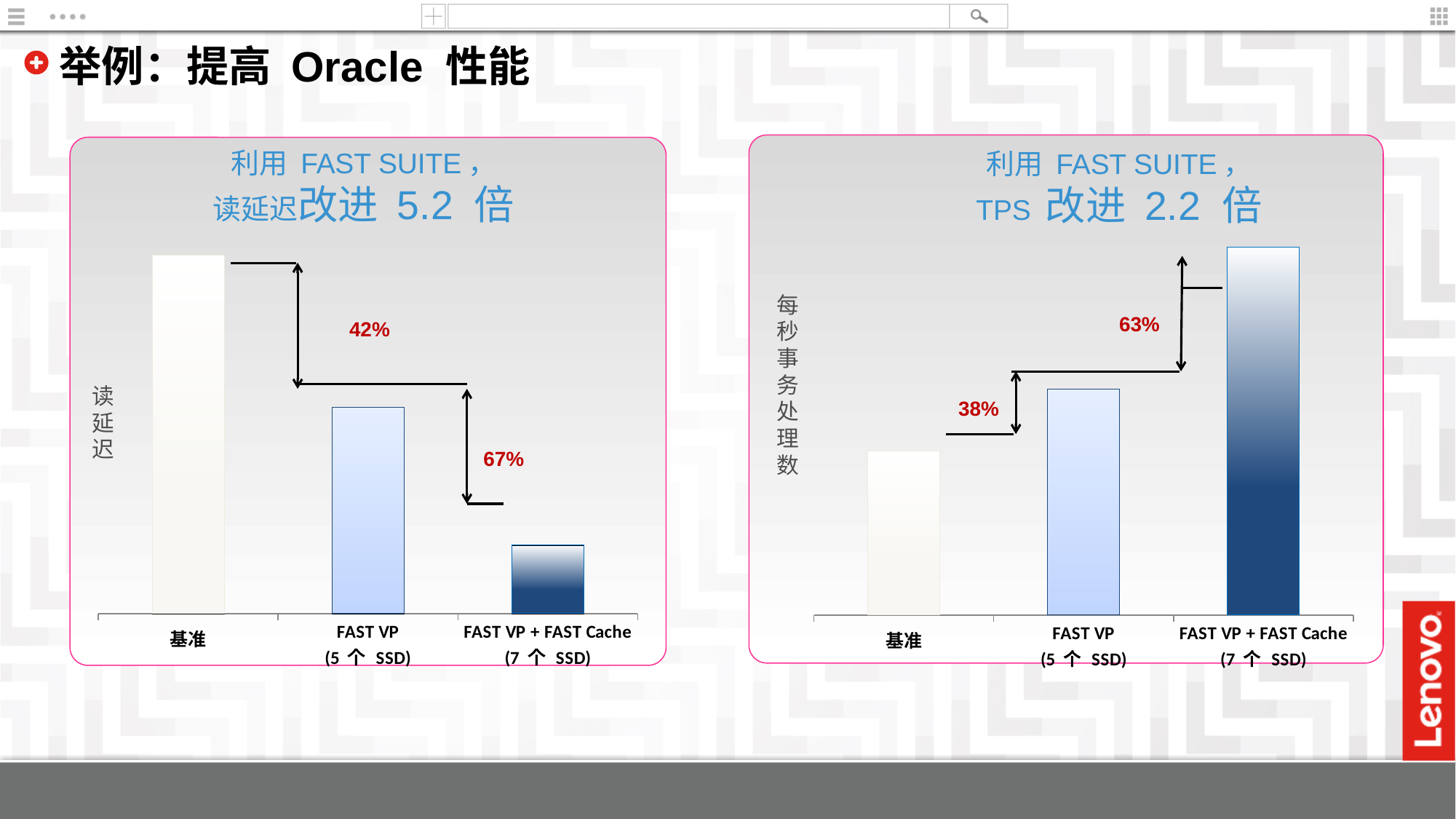
What kind of chart is the left chart (读延迟)? bar chart In the right chart (每秒事务处理数), do the bars rise or fall from left to right? rise In the left chart (读延迟), which category has the highest bar? 基准 In the right chart (每秒事务处理数), which category has the highest bar? FAST VP + FAST Cache (7 个 SSD) In the right chart (每秒事务处理数), which category has the lowest bar? 基准 In the right chart (每秒事务处理数), which is larger: the bar for 基准 or the bar for FAST VP (5 个 SSD)? FAST VP (5 个 SSD) In the left chart (读延迟), do the bars rise or fall from left to right? fall In the left chart (读延迟), which category has the lowest bar? FAST VP + FAST Cache (7 个 SSD) According to the title of the right chart, by how many times does TPS improve with FAST SUITE? 2.2 倍 How many categories are shown on the x axis of the right chart (每秒事务处理数)? 3 In the left chart (读延迟), what percentage is labelled between the 基准 bar and the FAST VP (5 个 SSD) bar? 42% In the right chart (每秒事务处理数), what percentage is labelled between the FAST VP (5 个 SSD) bar and the FAST VP + FAST Cache (7 个 SSD) bar? 63%